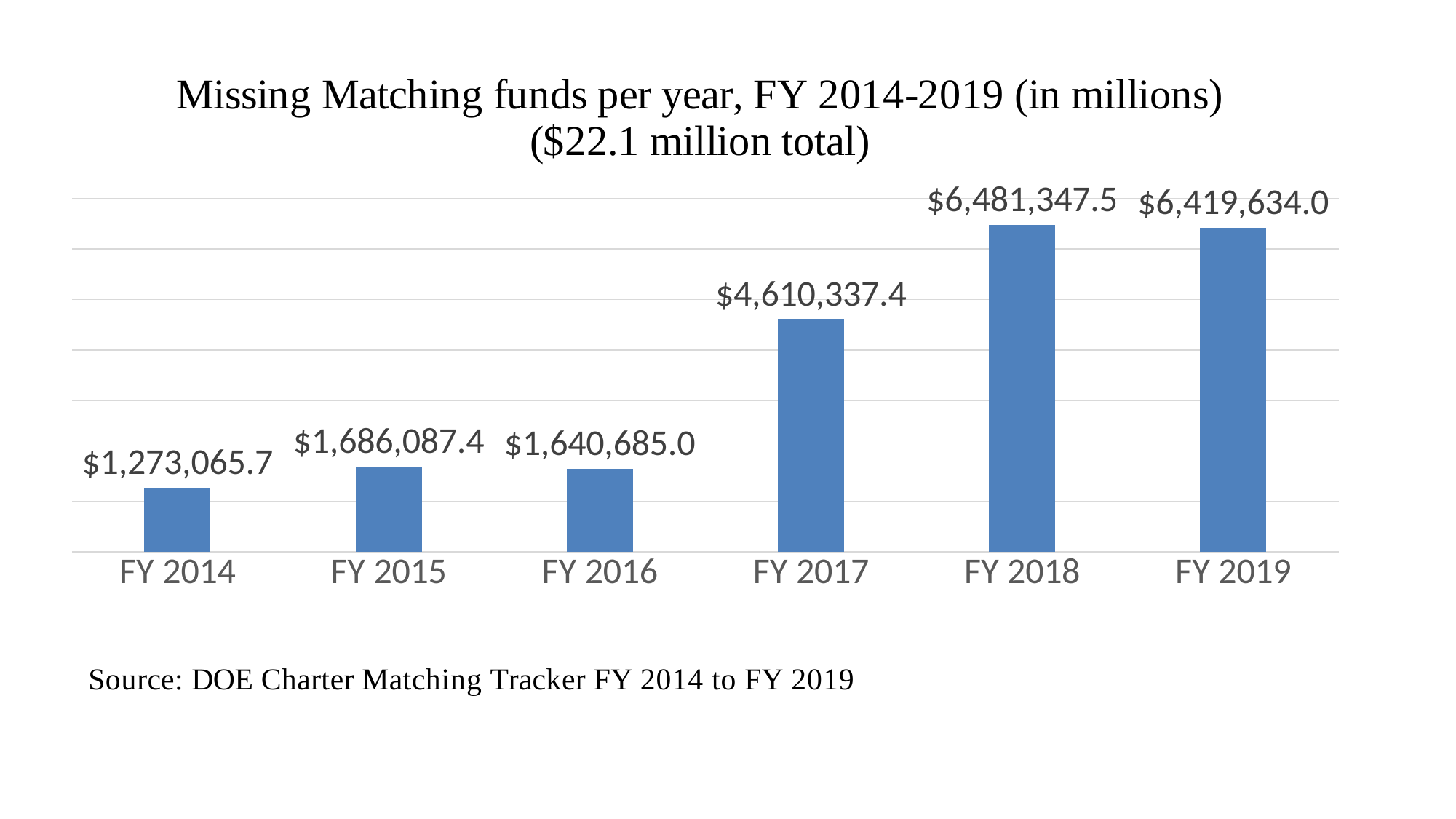
What is the value for FY 2014? $1,273,065.7 How many fiscal years are shown on the chart? 6 What is the difference between the values for FY 2015 and FY 2016? $45,402.4 Which fiscal year has the lowest value? FY 2014 Which is larger, the value for FY 2015 or FY 2016? FY 2015 What kind of chart is shown on the slide? Bar chart Which fiscal year has the highest value? FY 2018 What total amount is stated in the chart title? $22.1 million What is the difference between the values for FY 2018 and FY 2019? $61,713.5 What is the value for FY 2017? $4,610,337.4 Do the values rise or fall from FY 2016 to FY 2018? Rise What is the value for FY 2019? $6,419,634.0